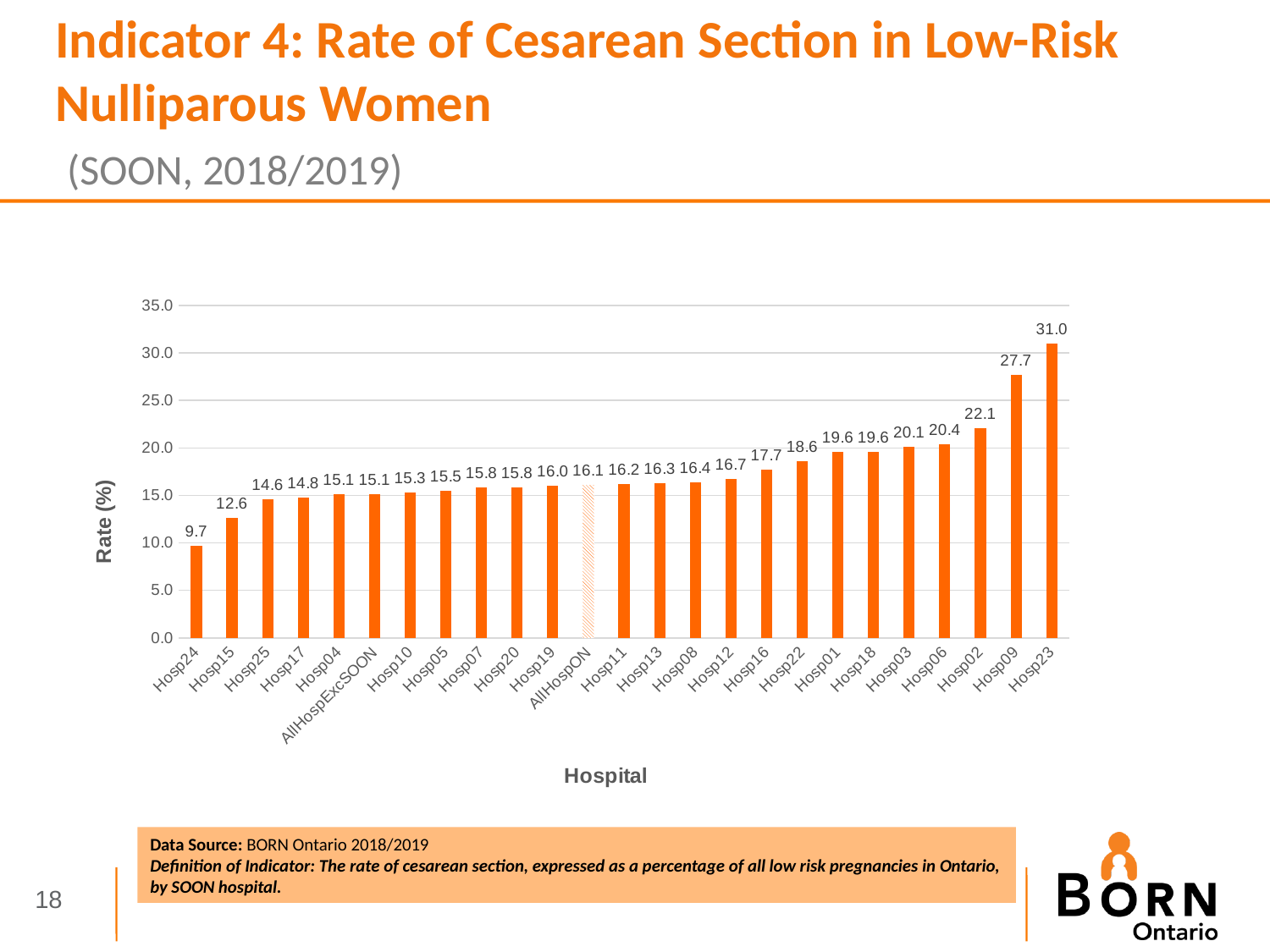
Which has a higher rate, Hosp16 or Hosp22? Hosp22 What is the rate for AllHospON? 16.1 What kind of chart is shown on the slide? Bar chart Which hospital has the lowest rate? Hosp24 What is the rate for Hosp02? 22.1 What is the difference between the rates for AllHospON and AllHospExcSOON? 1.0 Is the value for Hosp09 greater or less than 25.0? greater Which hospital has the highest rate? Hosp23 How many bars are plotted on the chart? 25 What is the rate for Hosp23? 31.0 Do the values rise or fall from left to right along the x axis? Rise What is the difference between the rates for Hosp23 and Hosp09? 3.3